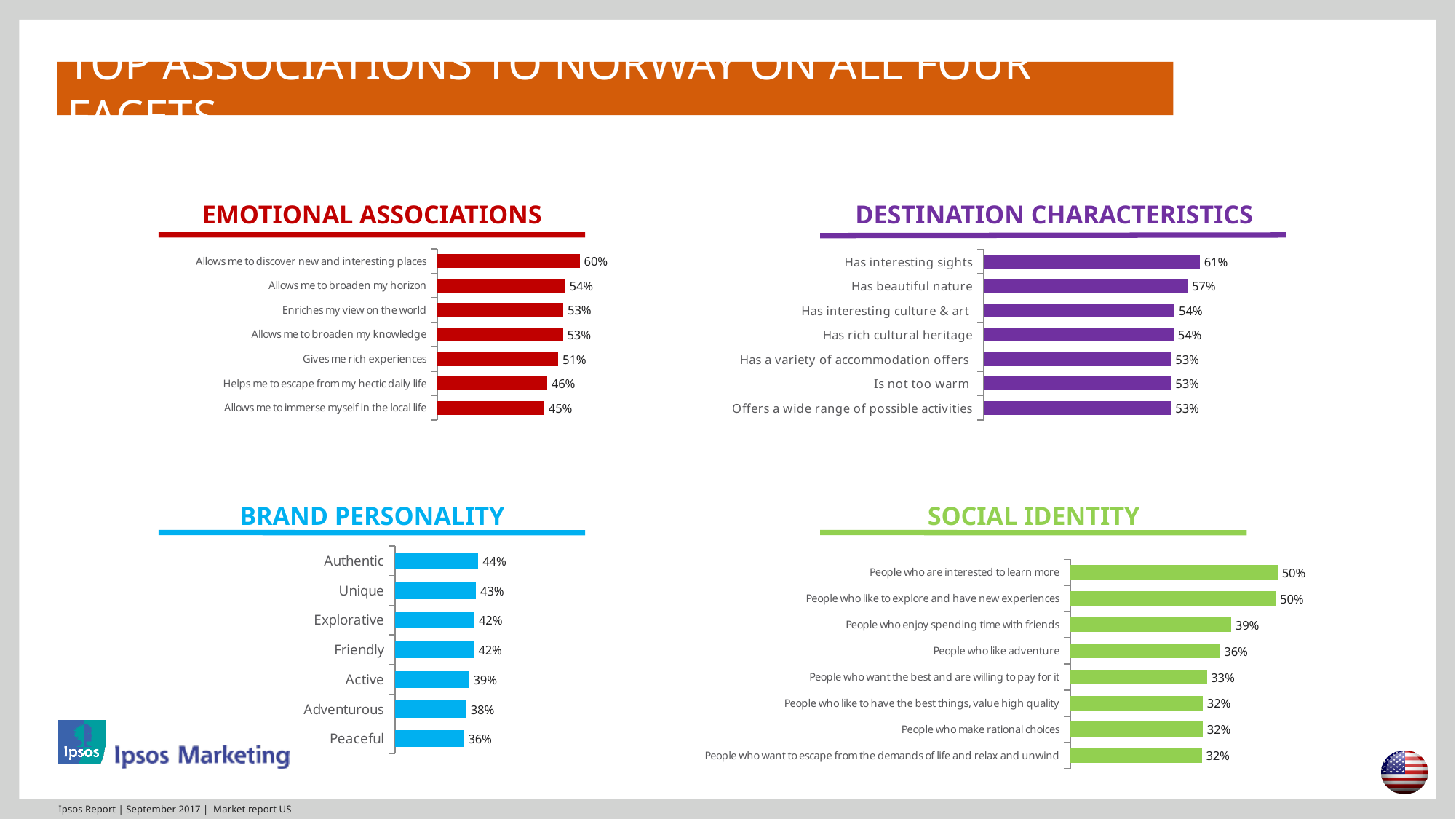
In the Emotional Associations chart, which category has the lowest value? Allows me to immerse myself in the local life In the Social Identity chart, how many categories are shown? 8 In the Brand Personality chart, what is the value for "Peaceful"? 36% In the Brand Personality chart, how many categories are shown? 7 In the Emotional Associations chart, what is the value for "Allows me to discover new and interesting places"? 60% What type of chart is the Emotional Associations chart? Bar chart In the Destination Characteristics chart, what is the difference between "Has interesting sights" and "Is not too warm"? 8% In the Destination Characteristics chart, which category has the highest value? Has interesting sights In the Destination Characteristics chart, what is the value for "Has beautiful nature"? 57% In the Social Identity chart, what is the difference between "People who are interested to learn more" and "People who enjoy spending time with friends"? 11% In the Social Identity chart, what is the value for "People who like adventure"? 36% In the Brand Personality chart, which is larger, "Authentic" or "Active"? Authentic